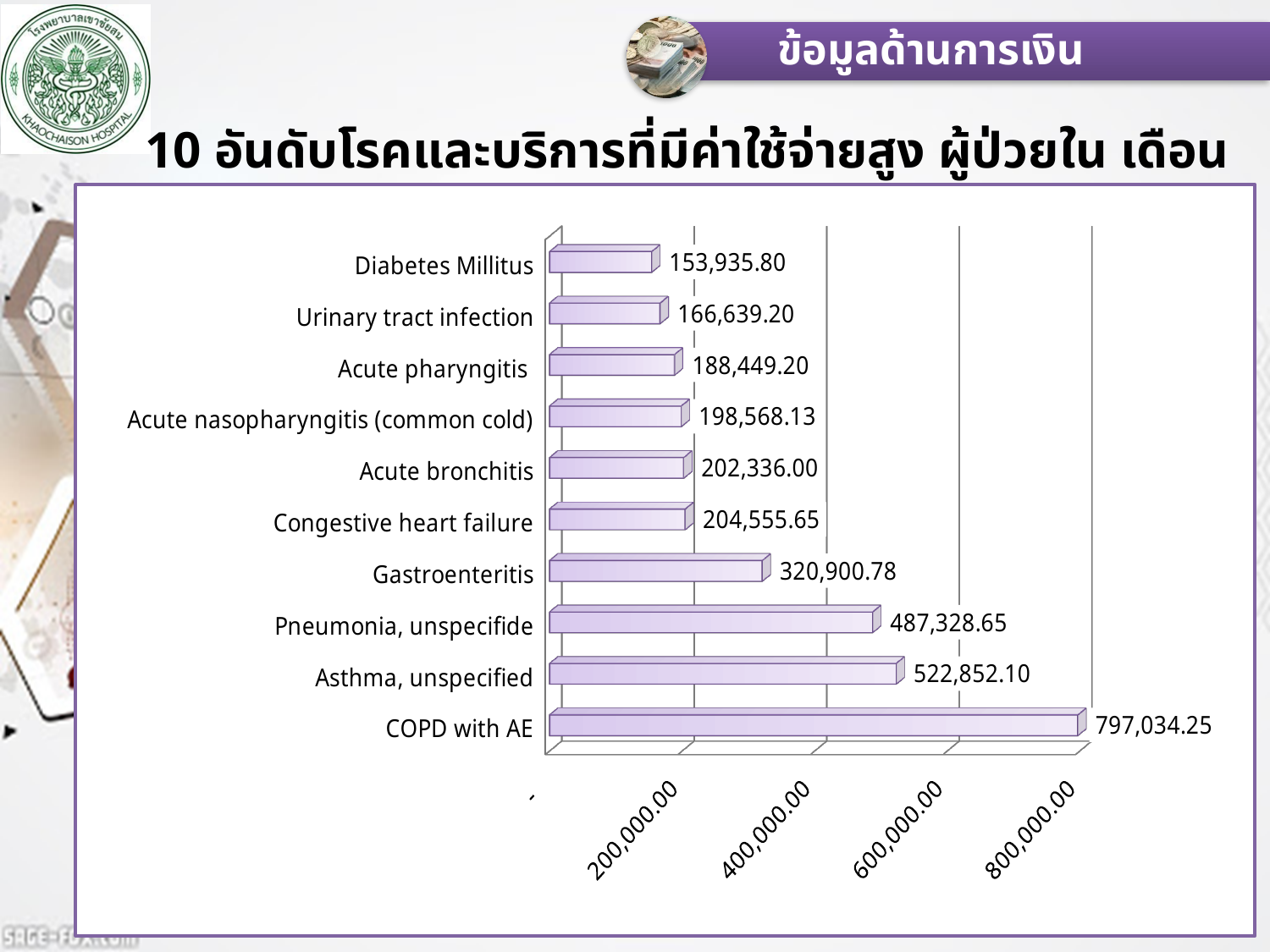
What is the value for COPD with AE? 797,034.25 What is the difference between the values for Gastroenteritis and Congestive heart failure? 116,345.13 Which category has the lowest value? Diabetes Millitus How many categories are shown in the chart? 10 Which category has the highest value? COPD with AE What kind of chart is shown on the slide? bar chart Is the value for Pneumonia, unspecifide greater or less than 400,000.00? greater Which is larger, the value for Gastroenteritis or the value for Acute bronchitis? Gastroenteritis What is the value for Diabetes Millitus? 153,935.80 What is the value for Gastroenteritis? 320,900.78 What is the difference between the values for COPD with AE and Asthma, unspecified? 274,182.15 What is the value for Acute nasopharyngitis (common cold)? 198,568.13